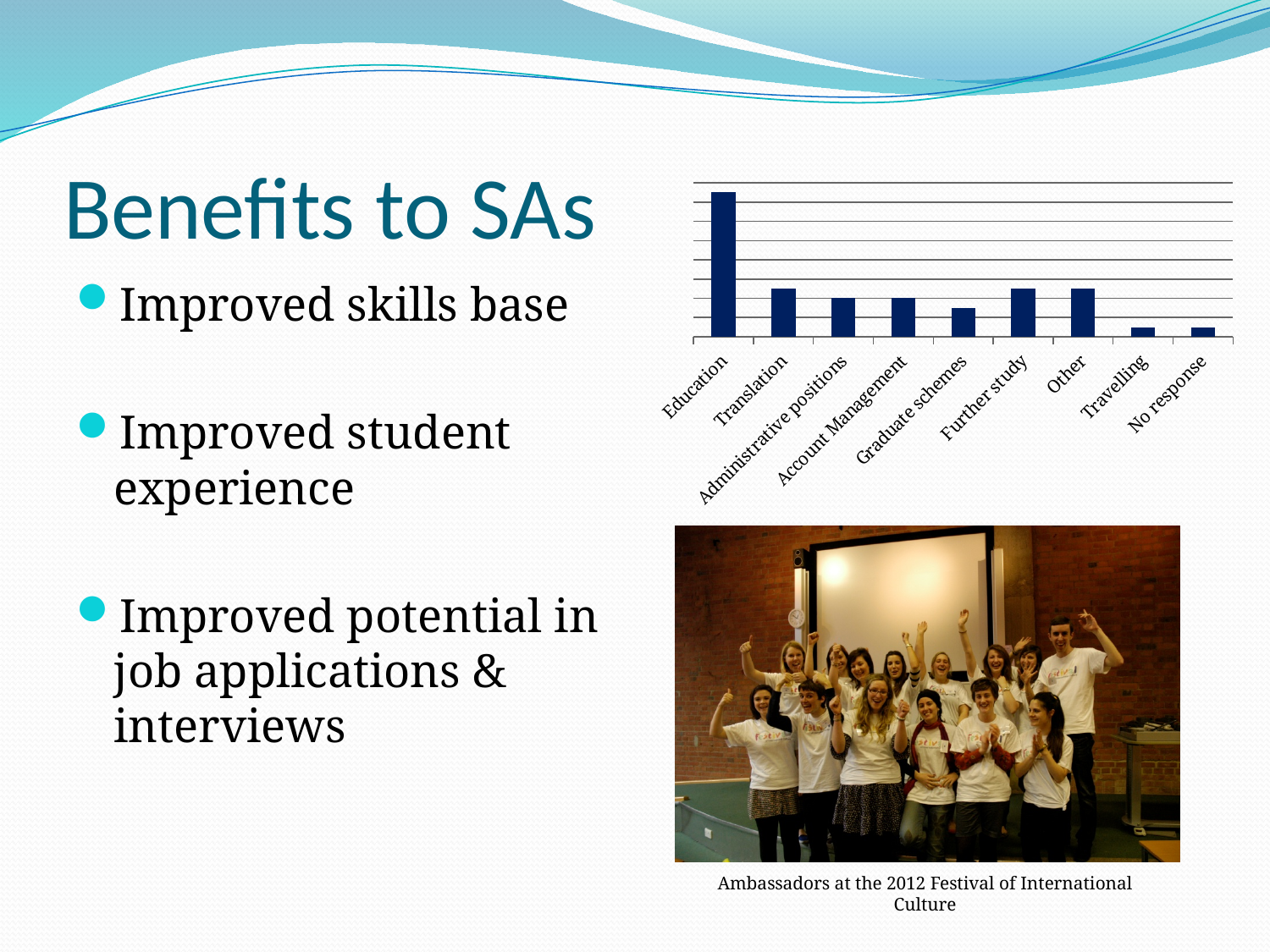
Which is larger in the chart, the value for Education or the value for Translation? Education Which is larger in the chart, the value for Translation or the value for Graduate schemes? Translation Which category has the highest bar in the chart? Education Which is larger in the chart, the value for Further study or the value for No response? Further study What is the label of the first category on the x axis of the chart? Education What kind of chart is shown on the slide? bar chart How many categories are shown on the x axis of the bar chart? 9 What colour are the bars in the chart? dark blue